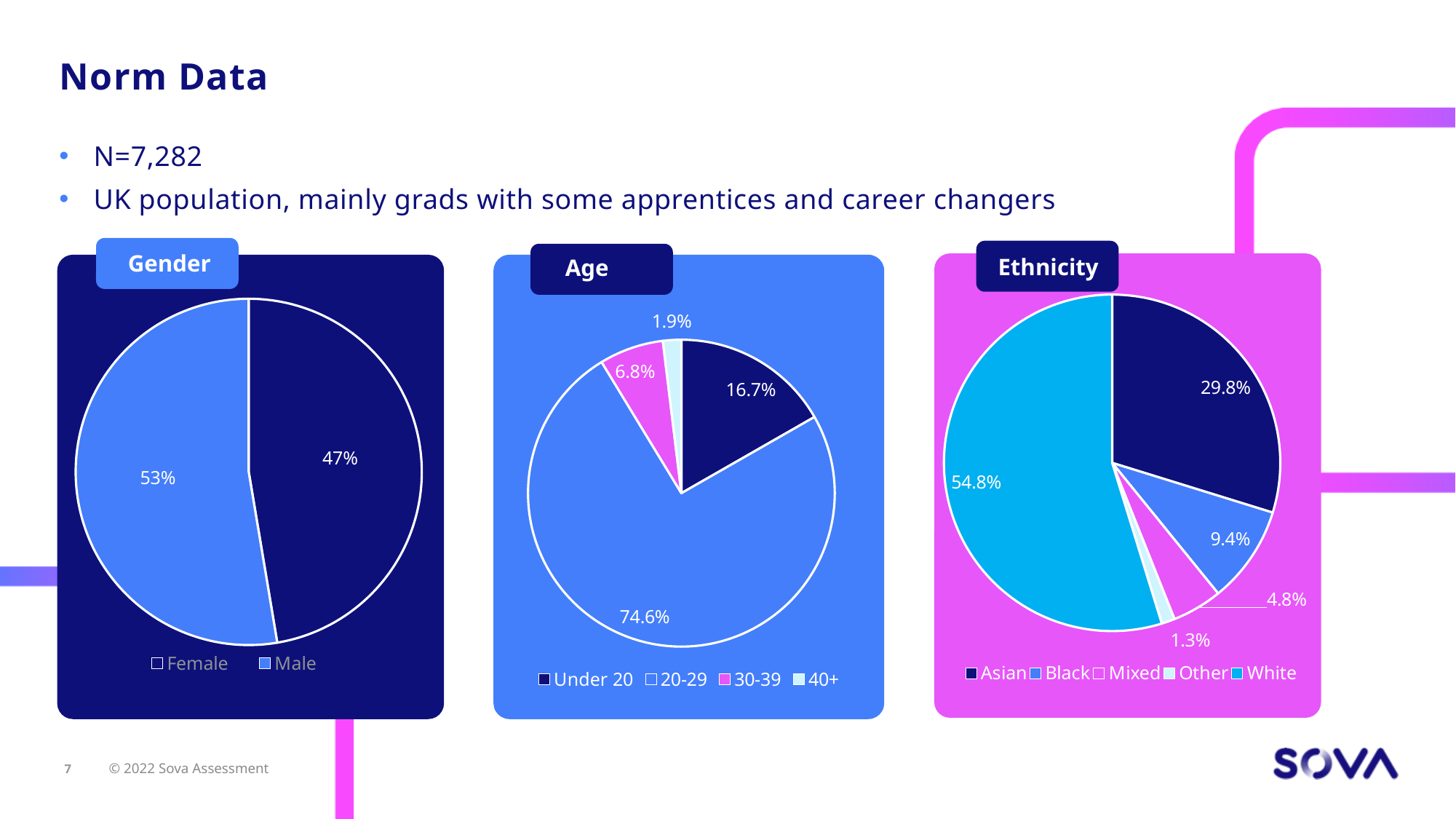
What kind of charts are shown on the slide? Pie charts In the Ethnicity pie chart, which is larger, the Mixed share or the Other share? Mixed In the Gender pie chart, what is the difference between the two percentages shown? 6 percentage points In the Ethnicity pie chart, which category has the largest share? White In the Age pie chart, what percentage is shown for Under 20? 16.7% How many categories does the legend of the Ethnicity pie chart list? 5 In the Ethnicity pie chart, what percentage is shown for Black? 9.4% In the Age pie chart, what is the difference between the 30-39 share and the 40+ share? 4.9 percentage points In the Age pie chart, what percentage is shown for the 20-29 group? 74.6% How many pie charts are on the slide? 3 In the Ethnicity pie chart, what percentage is shown for Asian? 29.8% In the Age pie chart, which age group has the smallest share? 40+